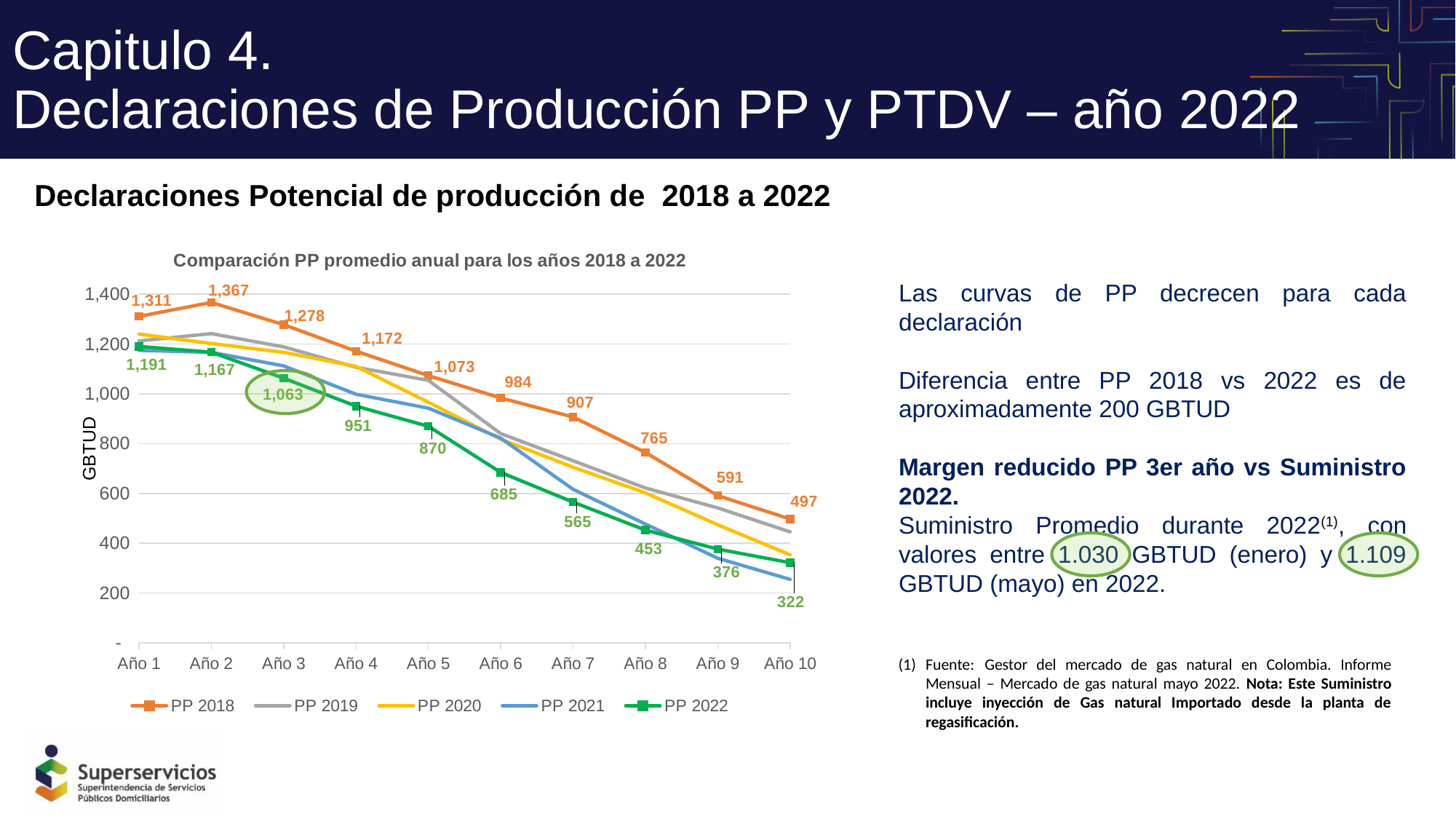
Which is larger in Año 7: PP 2018 or PP 2022? PP 2018 What is the value for PP 2022 in Año 10? 322 In which year does the PP 2022 series reach its lowest value? Año 10 In which year does the PP 2018 series reach its highest value? Año 2 How many years (categories) are shown on the x axis? 10 What type of chart is shown on the slide? line chart What is the value for PP 2018 in Año 10? 497 What is the value for PP 2018 in Año 2? 1,367 What is the difference between PP 2018 and PP 2022 in Año 1? 120 What is the value for PP 2022 in Año 3? 1,063 How many series does the legend list? 5 Do the PP 2022 values rise or fall from Año 1 to Año 10? fall